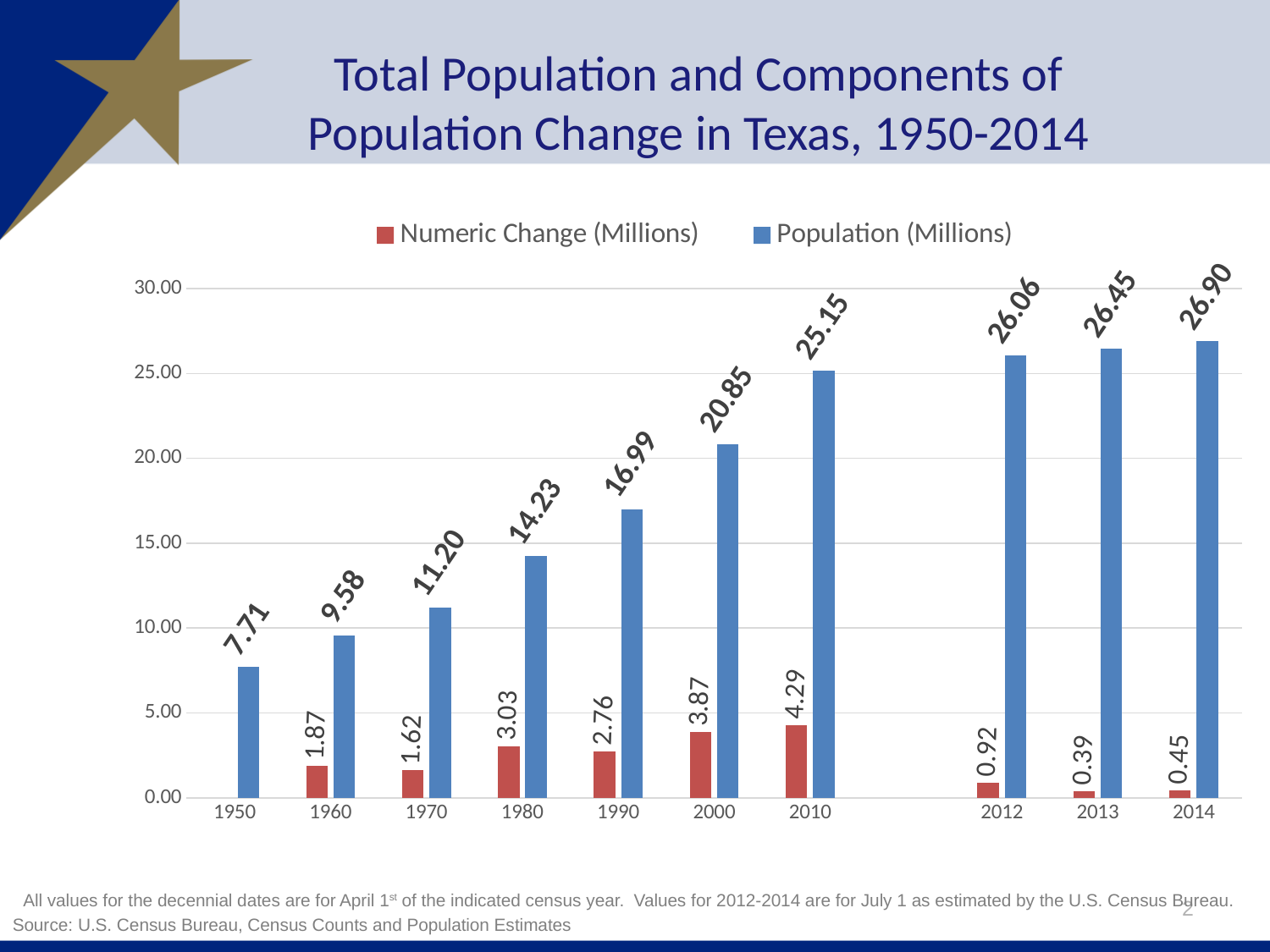
Which is larger, the Numeric Change (Millions) for 1960 or for 1970? 1960 Which year has the lowest Numeric Change (Millions)? 2013 What kind of chart is shown on the slide? Bar chart What is the Numeric Change (Millions) value for 1980? 3.03 How many series does the legend list? 2 What is the Population (Millions) value for 1950? 7.71 How many years are shown on the x axis? 10 Does the Population (Millions) series rise or fall from 1950 to 2014? Rise Which year has the highest Numeric Change (Millions)? 2010 What is the difference between the Population (Millions) values for 2014 and 2010? 1.75 What is the Population (Millions) value for 2010? 25.15 Is the Population (Millions) value for 1990 greater or less than 15.00? greater